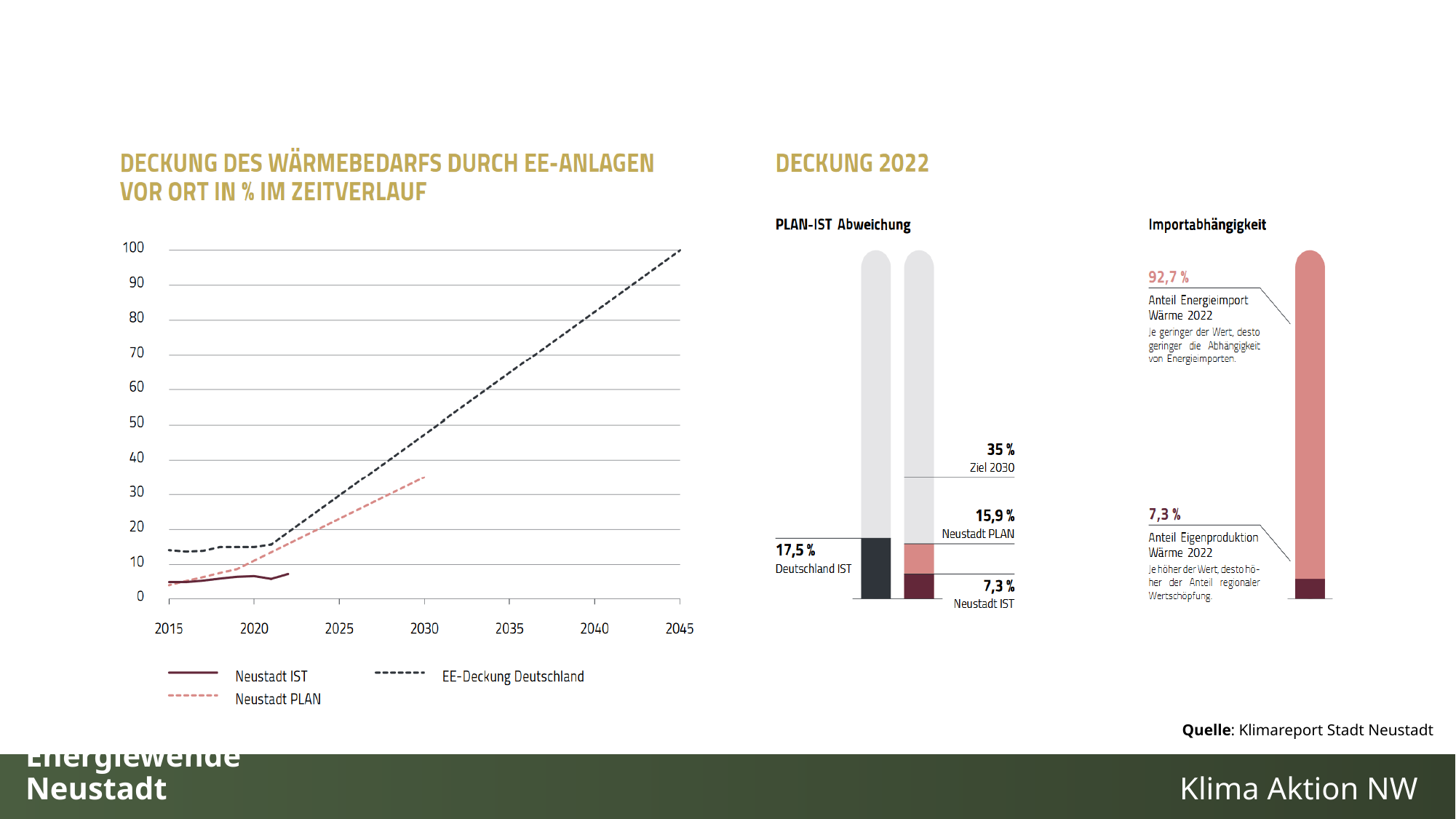
In the 'PLAN-IST Abweichung' chart under 'Deckung 2022', what is the difference between Ziel 2030 and Neustadt IST? 27,7 % In the 'PLAN-IST Abweichung' chart under 'Deckung 2022', which labelled value is the highest? Ziel 2030 (35 %) In the chart 'Deckung des Wärmebedarfs durch EE-Anlagen vor Ort in % im Zeitverlauf', is the value of Neustadt IST in 2022 greater or less than 10? less In the 'PLAN-IST Abweichung' chart under 'Deckung 2022', what is the value for Neustadt PLAN? 15,9 % In the 'Importabhängigkeit' chart under 'Deckung 2022', what is the difference between Anteil Energieimport Wärme 2022 and Anteil Eigenproduktion Wärme 2022? 85,4 % What kind of chart is the chart titled 'Deckung des Wärmebedarfs durch EE-Anlagen vor Ort in % im Zeitverlauf'? line chart In the chart 'Deckung des Wärmebedarfs durch EE-Anlagen vor Ort in % im Zeitverlauf', does the EE-Deckung Deutschland line rise or fall from 2020 to 2045? rise In the chart 'Deckung des Wärmebedarfs durch EE-Anlagen vor Ort in % im Zeitverlauf', which series has the higher value in 2020: Neustadt IST or EE-Deckung Deutschland? EE-Deckung Deutschland In the 'Importabhängigkeit' chart under 'Deckung 2022', what is the Anteil Energieimport Wärme 2022? 92,7 % How many series does the legend of the chart 'Deckung des Wärmebedarfs durch EE-Anlagen vor Ort in % im Zeitverlauf' list? 3 In the 'PLAN-IST Abweichung' chart under 'Deckung 2022', what is the value for Deutschland IST? 17,5 % In the chart 'Deckung des Wärmebedarfs durch EE-Anlagen vor Ort in % im Zeitverlauf', is the value of Neustadt PLAN in 2030 greater or less than 30? greater